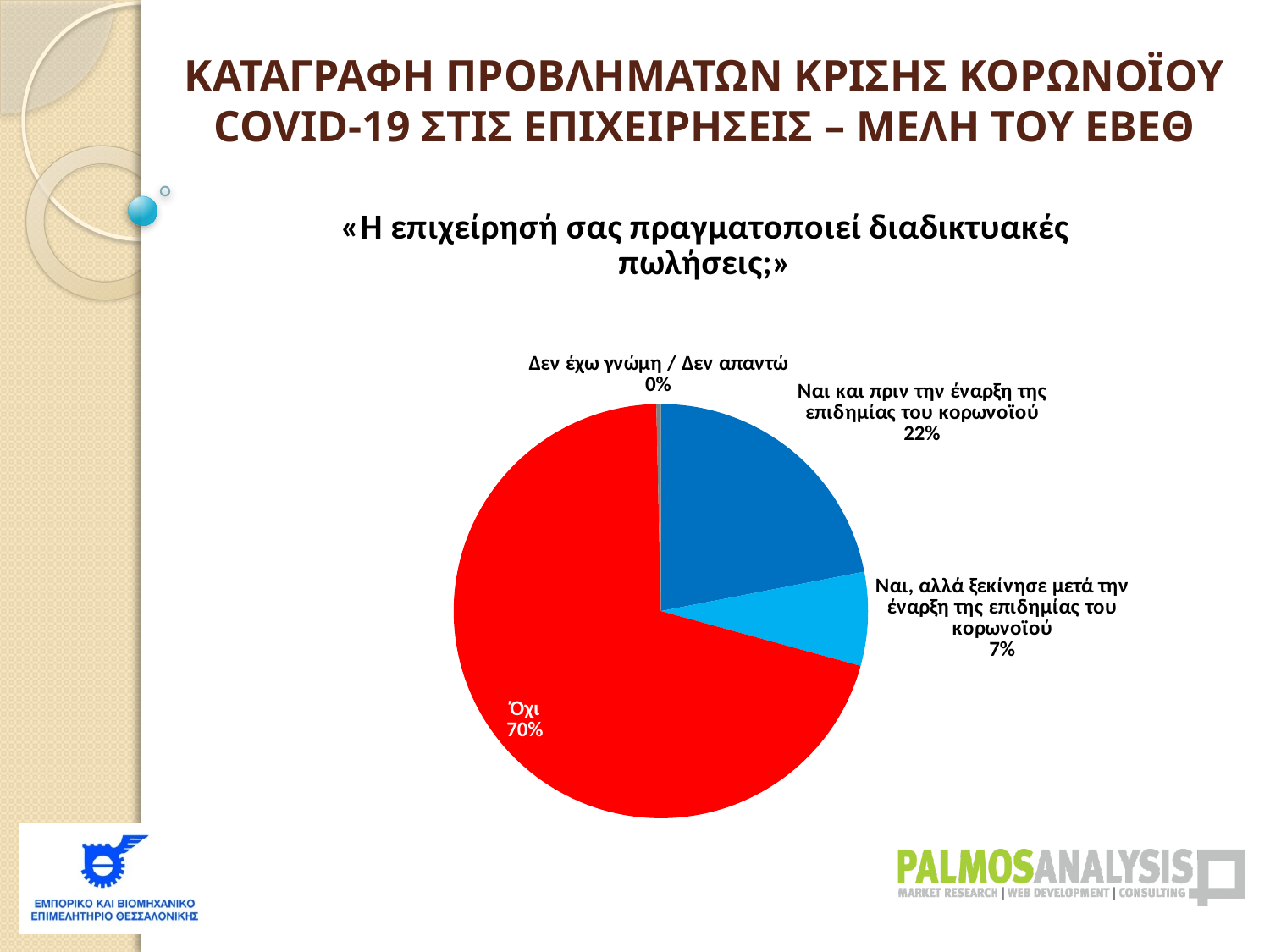
What percentage answered «Ναι, αλλά ξεκίνησε μετά την έναρξη της επιδημίας του κορωνοϊού»? 7% What percentage answered «Ναι και πριν την έναρξη της επιδημίας του κορωνοϊού»? 22% Which response has the smallest share of the pie? Δεν έχω γνώμη / Δεν απαντώ What percentage answered «Δεν έχω γνώμη / Δεν απαντώ»? 0% What percentage of respondents answered «Όχι»? 70% How many response categories are shown in the pie chart? 4 Which response has the largest share of the pie? Όχι What is the combined share of the two «Ναι» responses? 29% Which is larger: the share for «Ναι και πριν την έναρξη της επιδημίας του κορωνοϊού» or for «Ναι, αλλά ξεκίνησε μετά την έναρξη της επιδημίας του κορωνοϊού»? Ναι και πριν την έναρξη της επιδημίας του κορωνοϊού What colour is the «Όχι» slice of the pie? red What kind of chart is shown on the slide? pie chart What is the difference in percentage points between «Όχι» and «Ναι και πριν την έναρξη της επιδημίας του κορωνοϊού»? 48 percentage points